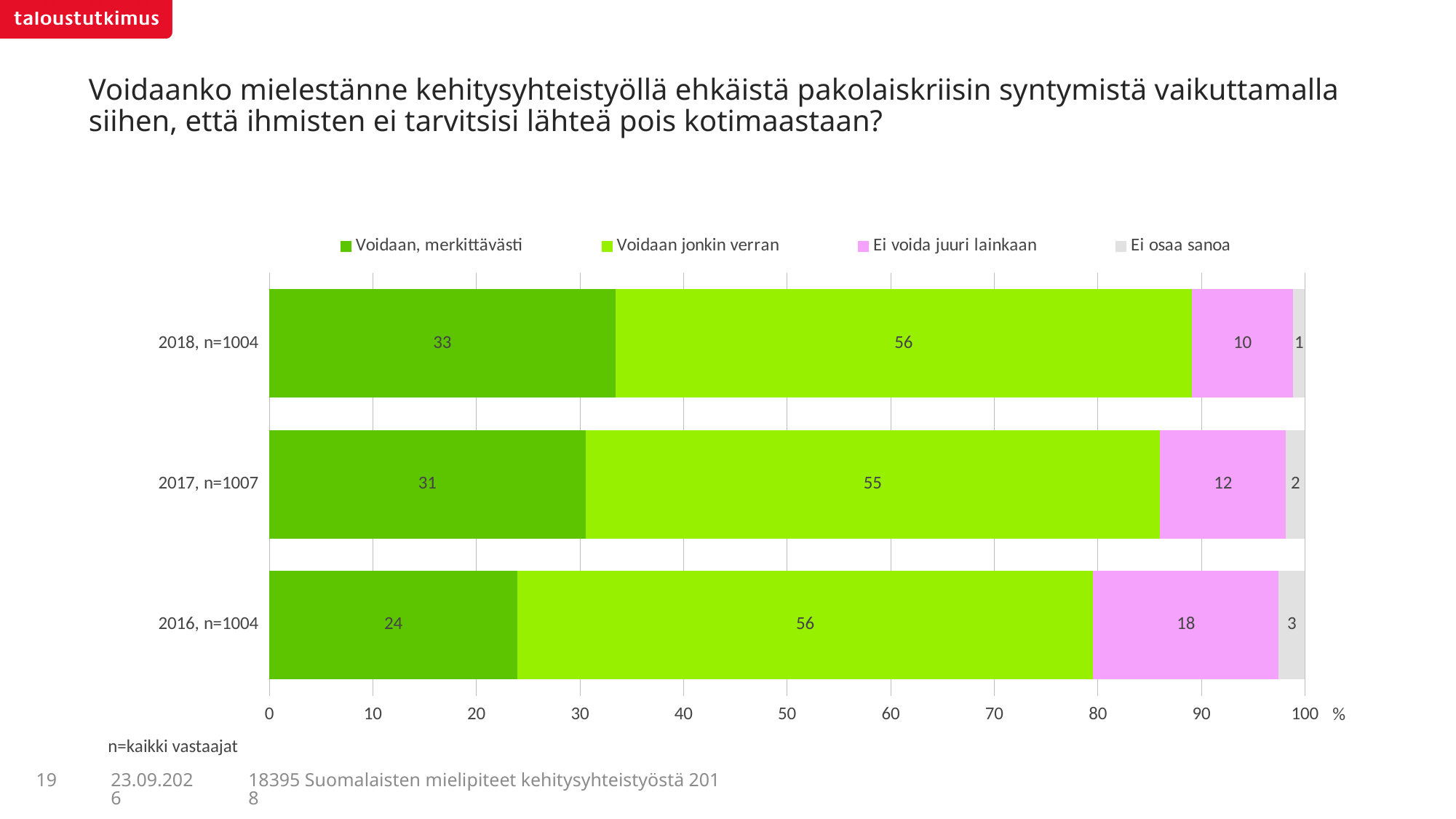
What kind of chart is shown on the slide? Stacked bar chart What is the total of the stacked bar for 2016, n=1004? 101 How many series does the legend list? 4 What is the value for "Ei osaa sanoa" in 2017, n=1007? 2 Which year has the highest value for "Voidaan, merkittävästi"? 2018, n=1004 What is the value for "Voidaan, merkittävästi" in 2018, n=1004? 33 What is the value for "Ei voida juuri lainkaan" in 2016, n=1004? 18 How many categories (years) are shown on the chart? 3 What is the difference between the "Voidaan, merkittävästi" values for 2018, n=1004 and 2016, n=1004? 9 Which year has the lowest value for "Ei voida juuri lainkaan"? 2018, n=1004 What is the value for "Voidaan jonkin verran" in 2017, n=1007? 55 Which is larger: the "Ei voida juuri lainkaan" value for 2017, n=1007 or for 2016, n=1004? 2016, n=1004